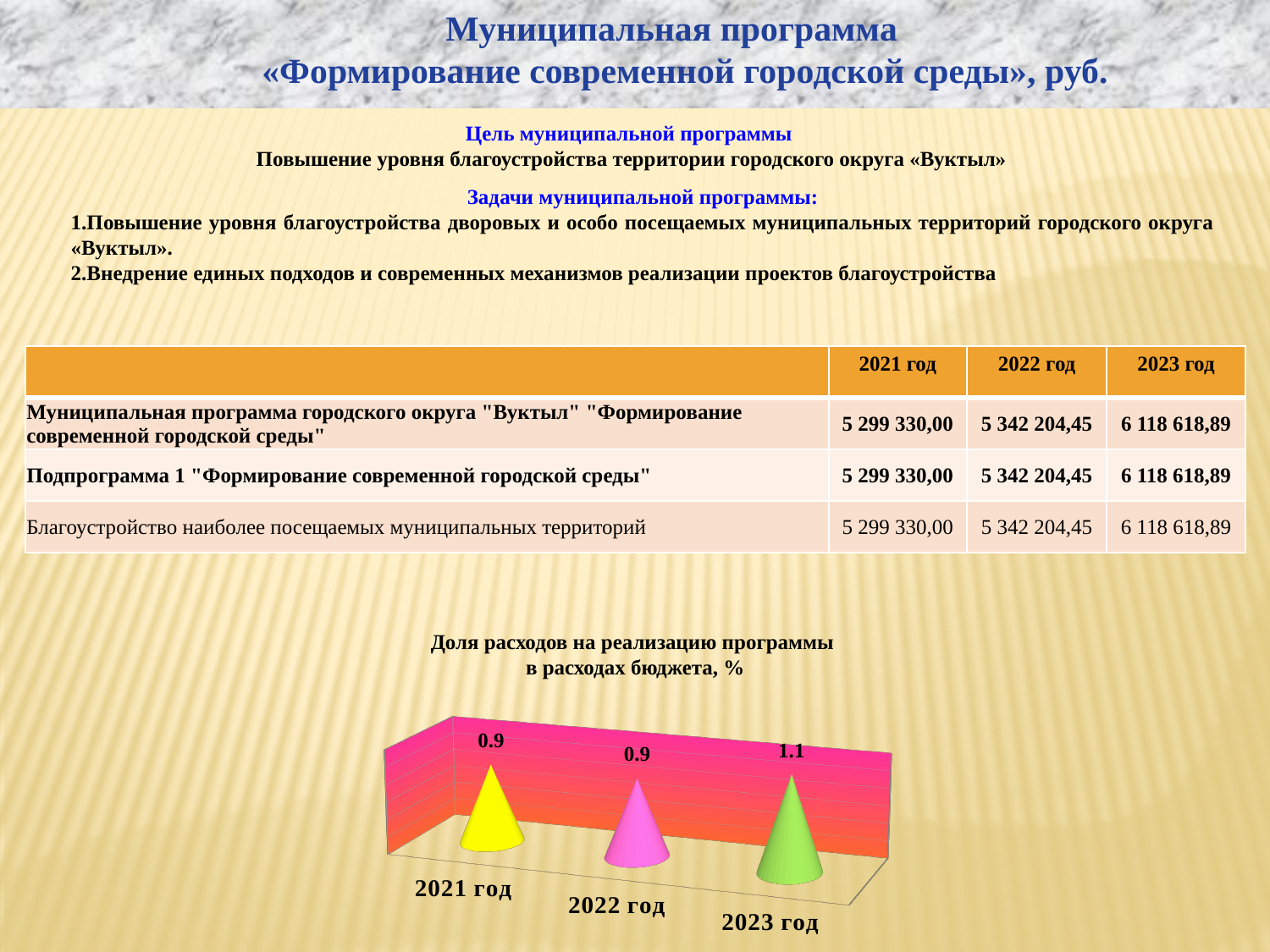
How many years are shown in the chart? 3 What kind of chart is shown at the bottom of the slide? Bar chart Do the values in the chart rise or fall from 2021 год to 2023 год? Rise What is the title of the chart? Доля расходов на реализацию программы в расходах бюджета, % What is the value for 2022 год in the chart? 0.9 What colour is the cone for 2023 год? Green What is the value for 2023 год in the chart? 1.1 What is the difference between the values for 2023 год and 2021 год? 0.2 Which is larger, the value for 2023 год or the value for 2022 год? 2023 год What is the value for 2021 год in the chart 'Доля расходов на реализацию программы в расходах бюджета, %'? 0.9 Which year has the highest value in the chart? 2023 год